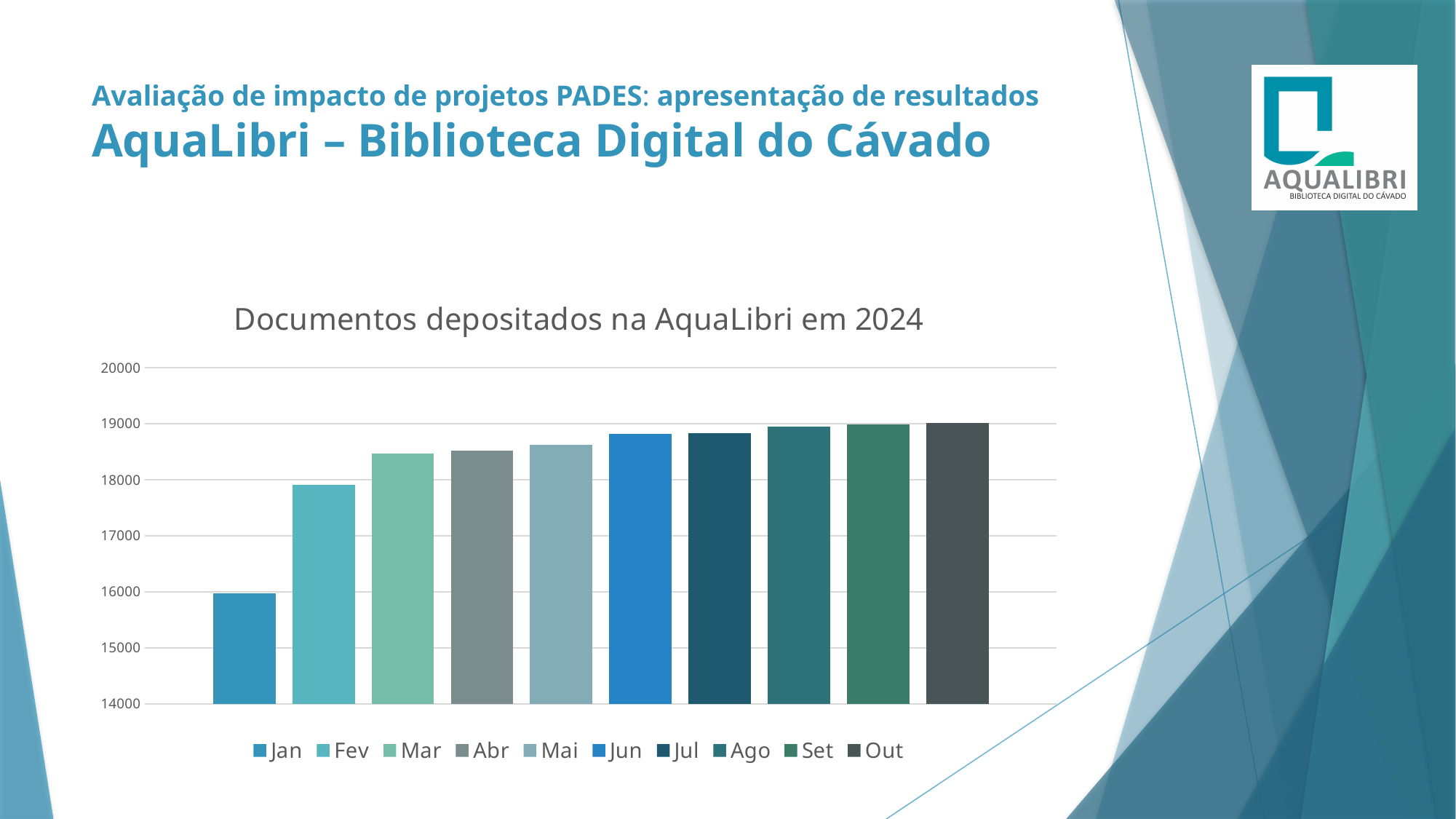
How many entries does the chart legend list? 10 Which month has the lowest value in the chart? Jan Is the value for Jan greater or less than 17000? less Do the values generally rise or fall from Jan to Out? rise Is the value for Mar greater or less than 18000? greater Is the value for Jun greater or less than 19000? less What is the title of the chart? Documentos depositados na AquaLibri em 2024 What kind of chart is shown on the slide? bar chart Which is larger, the value for Jan or the value for Fev? Fev How many bars (months) are plotted in the chart? 10 Which is larger, the value for Fev or the value for Jun? Jun